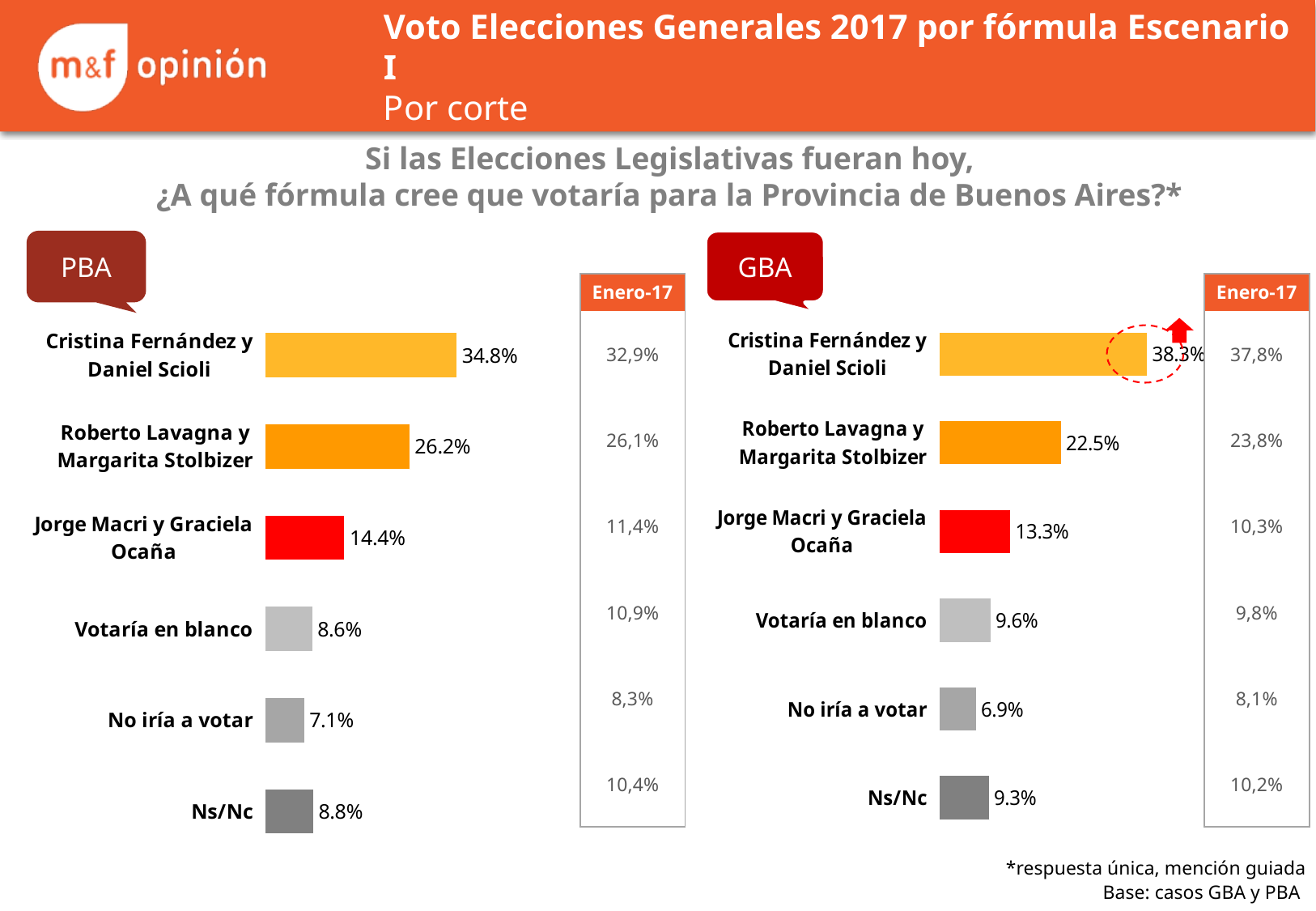
In the GBA chart, what is the value for Jorge Macri y Graciela Ocaña? 13.3% In the PBA chart, what is the value for No iría a votar? 7.1% In the PBA chart, what is the value for Cristina Fernández y Daniel Scioli? 34.8% In the GBA chart, which category has the lowest value? No iría a votar In the PBA chart, what is the difference between Cristina Fernández y Daniel Scioli and Roberto Lavagna y Margarita Stolbizer? 8.6% In the GBA chart, what is the difference between Votaría en blanco and Ns/Nc? 0.3% What kind of chart is the PBA chart? Bar chart In the PBA chart, which is larger: Votaría en blanco or Ns/Nc? Ns/Nc In the GBA chart, what is the value for Roberto Lavagna y Margarita Stolbizer? 22.5% How many categories does the GBA chart show? 6 In the PBA chart, which category has the highest value? Cristina Fernández y Daniel Scioli In the GBA chart, what was the Enero-17 value for Cristina Fernández y Daniel Scioli? 37,8%